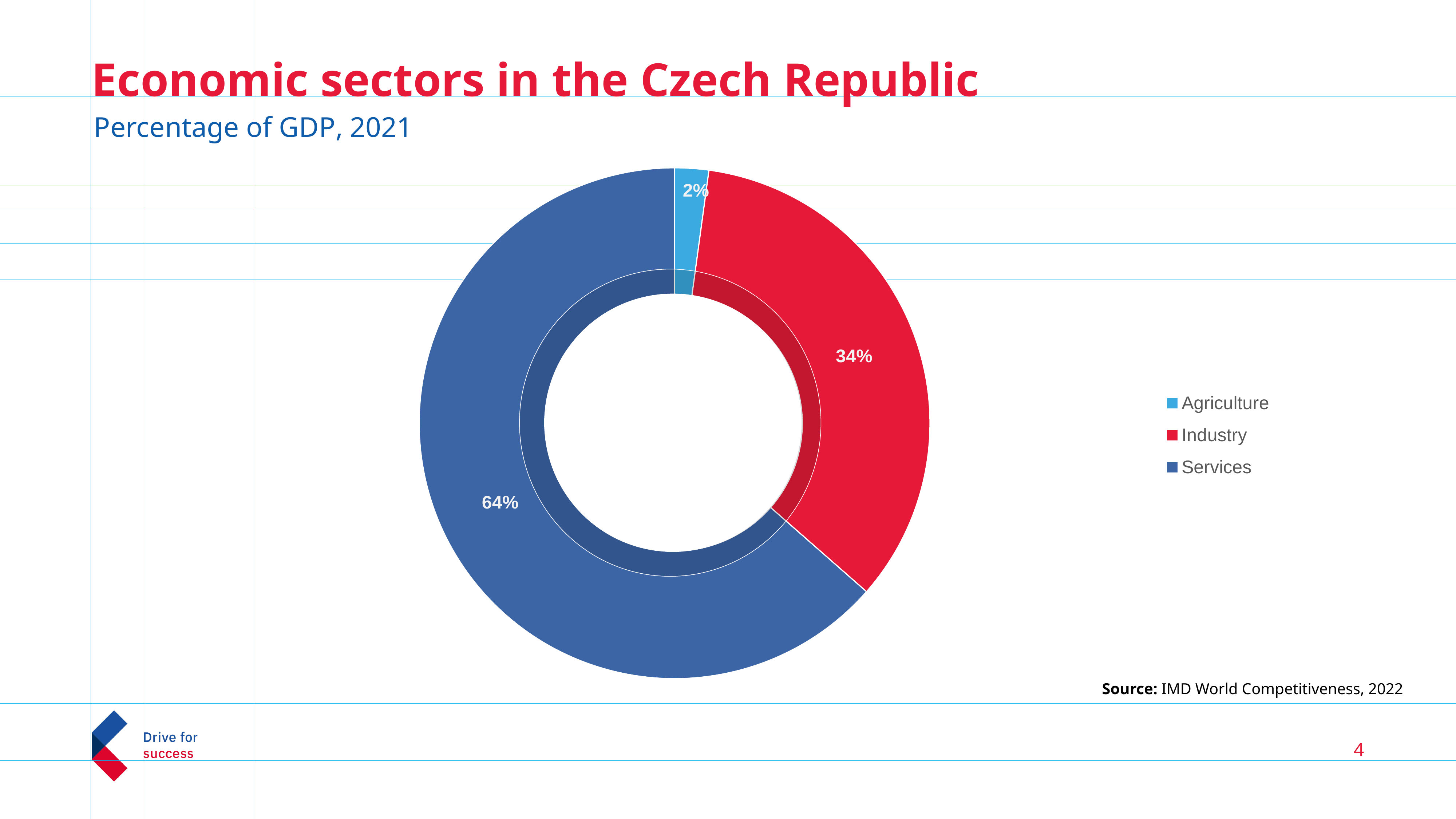
What is the title of the chart on the slide? Economic sectors in the Czech Republic Which sector has the smallest share of GDP? Agriculture What is the difference in percentage points between the Industry and Agriculture shares? 32 What colour represents Industry in the chart? Red Which is larger, the share for Industry or the share for Agriculture? Industry What kind of chart is shown on the slide? Doughnut chart What percentage of GDP does Agriculture account for? 2% What percentage of GDP does Industry account for? 34% What is the difference in percentage points between the Services and Industry shares? 30 What percentage of GDP does Services account for? 64% How many sectors are shown in the chart? 3 Which sector has the largest share of GDP? Services